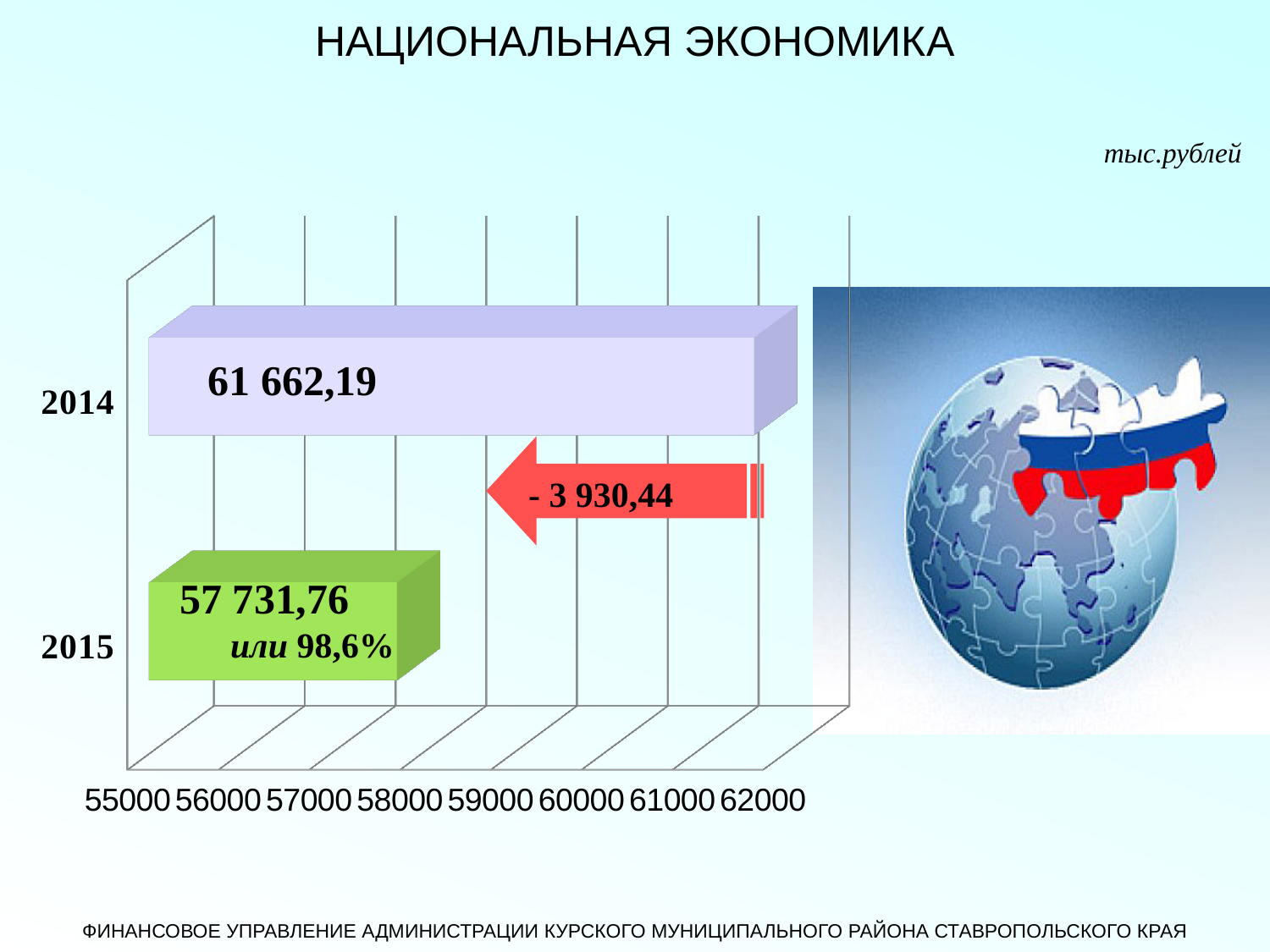
Is the value for 2014 greater or less than 61000? greater What is the difference between the 2014 and 2015 values? 3 930,44 What is the value for 2014? 61 662,19 Which year has the lowest value? 2015 What percentage is the 2015 value relative to 2014, as labelled on the chart? 98,6% What is the title of the chart? НАЦИОНАЛЬНАЯ ЭКОНОМИКА Is the value for 2015 greater or less than 58000? less How many years are shown in the chart? 2 What kind of chart is shown on the slide? bar chart Which year has the highest value? 2014 Which is larger, the value for 2014 or the value for 2015? 2014 What is the value for 2015? 57 731,76